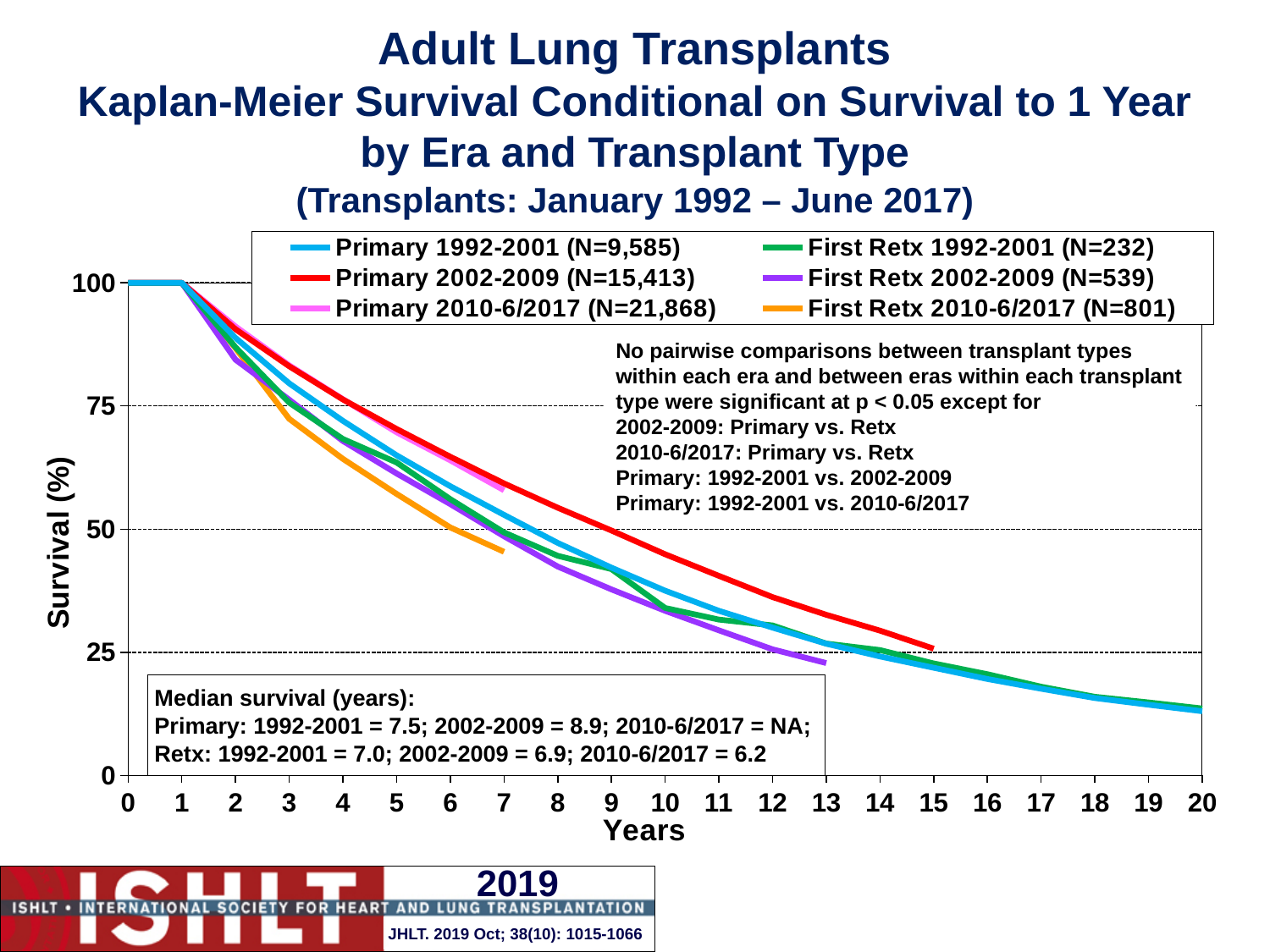
Which series has the highest survival at year 10? Primary 2002-2009 Which series has the lowest survival at year 5? First Retx 2010-6/2017 At year 5, which series has the higher survival: Primary 2002-2009 or First Retx 2010-6/2017? Primary 2002-2009 According to the legend, what is the N for Primary 2010-6/2017? N=21,868 What kind of chart is shown on the slide? line chart Is the survival value for Primary 1992-2001 at year 20 greater or less than 25? less Is the survival value for First Retx 2010-6/2017 at year 7 greater or less than 50? less Is the survival value for Primary 2002-2009 at year 5 greater or less than 50? greater How many series does the legend list? 6 Do the survival curves rise or fall as years increase along the x axis? fall What colour is the line for First Retx 1992-2001? green